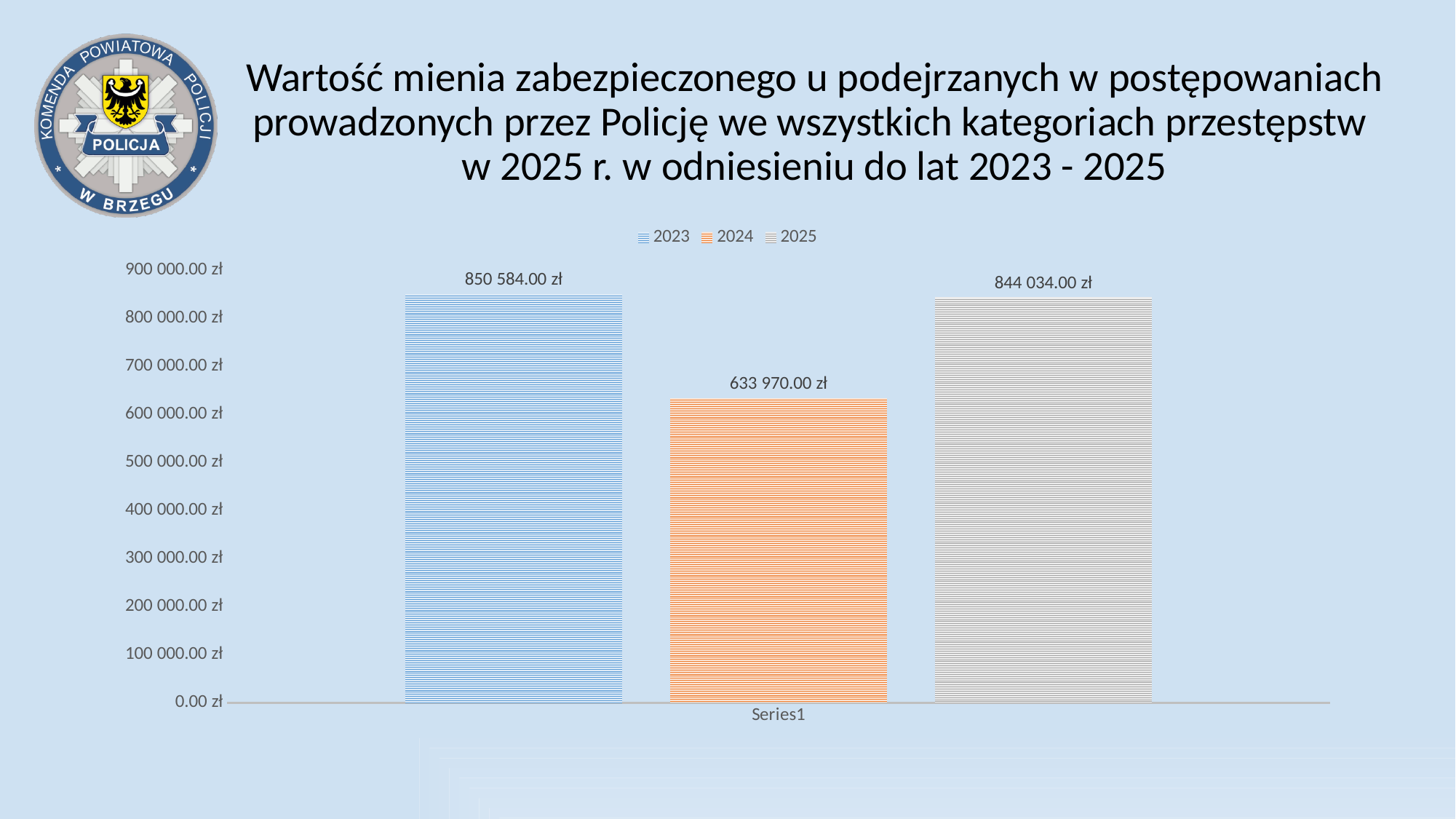
What is the difference between the 2023 and 2025 values? 6 550.00 zł Is the value for 2024 greater or less than 600 000.00 zł? greater Did the value rise or fall from 2023 to 2024? fall Which year has the lowest value? 2024 What kind of chart is shown on the slide? bar chart How many series does the legend list? 3 What is the value of the 2023 bar? 850 584.00 zł What is the difference between the 2023 and 2024 values? 216 614.00 zł Which is larger, the value for 2024 or the value for 2025? 2025 What is the value of the 2025 bar? 844 034.00 zł What is the value of the 2024 bar? 633 970.00 zł Which year has the highest value? 2023